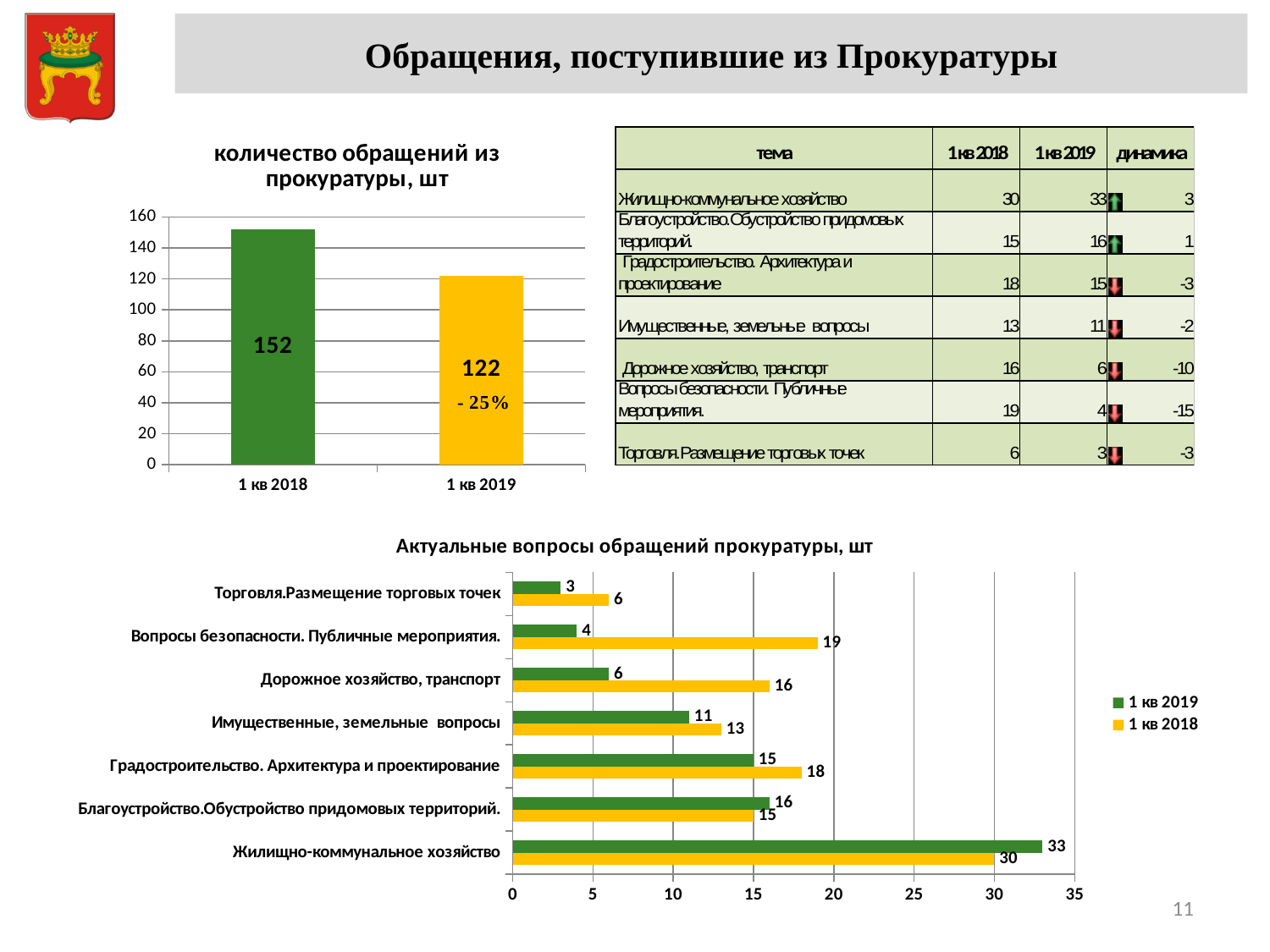
In the chart 'количество обращений из прокуратуры, шт', what is the value for 1 кв 2018? 152 In the chart 'количество обращений из прокуратуры, шт', what percentage change is printed next to the 1 кв 2019 bar? - 25% In the chart 'количество обращений из прокуратуры, шт', what is the value for 1 кв 2019? 122 How many series does the legend of the chart 'Актуальные вопросы обращений прокуратуры, шт' list? 2 In the chart 'Актуальные вопросы обращений прокуратуры, шт', which category has the lowest 1 кв 2019 value? Торговля.Размещение торговых точек In the chart 'количество обращений из прокуратуры, шт', what is the difference between the 1 кв 2018 and 1 кв 2019 values? 30 In the chart 'Актуальные вопросы обращений прокуратуры, шт', what is the 1 кв 2018 value for 'Вопросы безопасности. Публичные мероприятия.'? 19 In the chart 'Актуальные вопросы обращений прокуратуры, шт', which is larger for 'Благоустройство.Обустройство придомовых территорий.': the 1 кв 2019 value or the 1 кв 2018 value? 1 кв 2019 In the chart 'Актуальные вопросы обращений прокуратуры, шт', what is the 1 кв 2019 value for 'Дорожное хозяйство, транспорт'? 6 In the chart 'Актуальные вопросы обращений прокуратуры, шт', which category has the highest 1 кв 2019 value? Жилищно-коммунальное хозяйство How many categories are shown in the chart 'Актуальные вопросы обращений прокуратуры, шт'? 7 What kind of chart is 'Актуальные вопросы обращений прокуратуры, шт'? bar chart